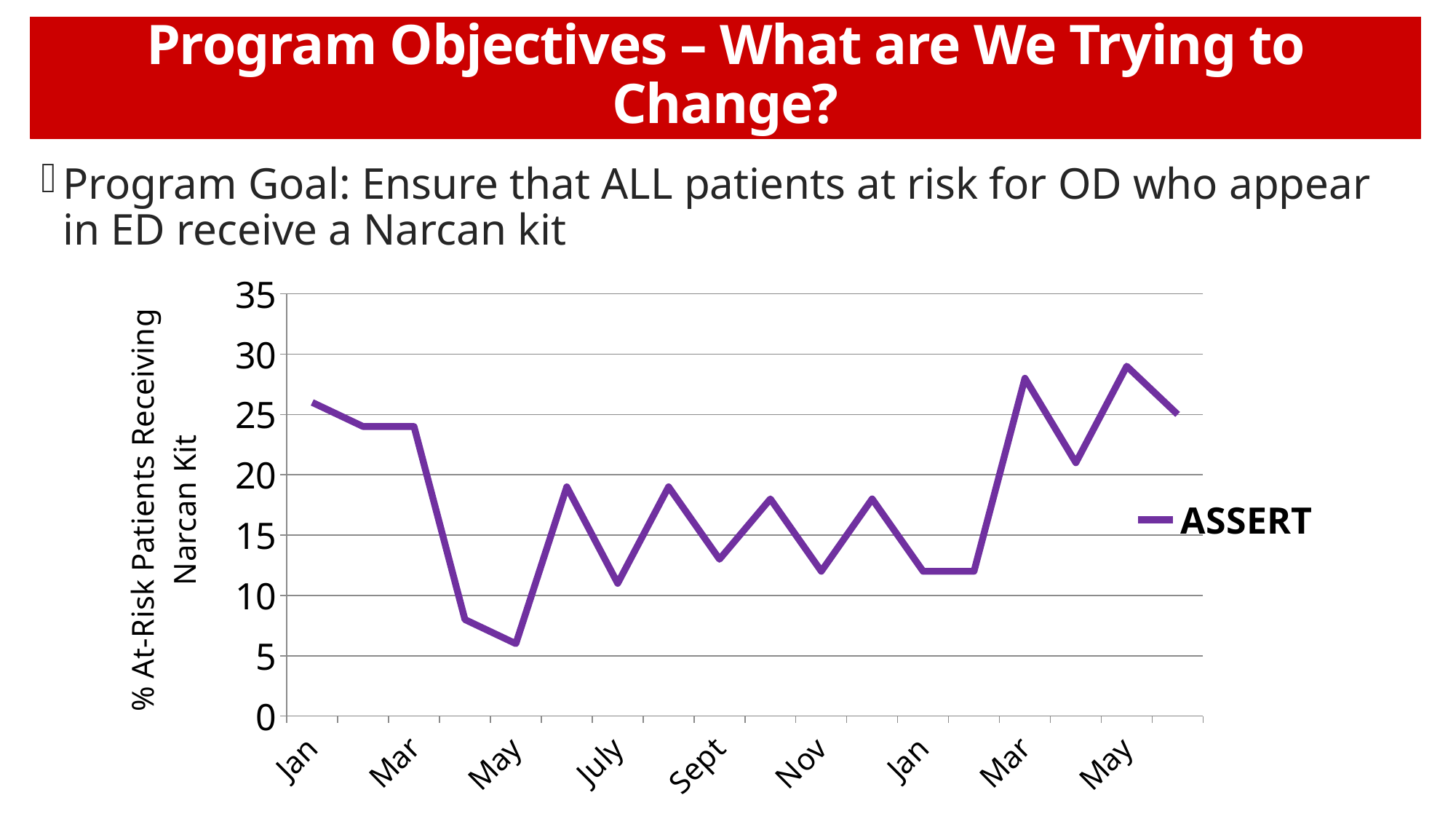
How many series does the legend list? 1 What is the name of the series shown in the legend? ASSERT Is the value for the second Mar greater or less than 25? greater What kind of chart is shown on the slide? line chart What is the title of the vertical axis? % At-Risk Patients Receiving Narcan Kit Is the value for Nov greater or less than 15? less Which of the labeled months has the lowest value? May (first year) Is the value for the first May greater or less than 10? less Which is larger, the value for the first Jan or the value for the first May? first Jan Do the values rise or fall from the first Jan to the first May? fall How many month labels are shown along the x axis? 9